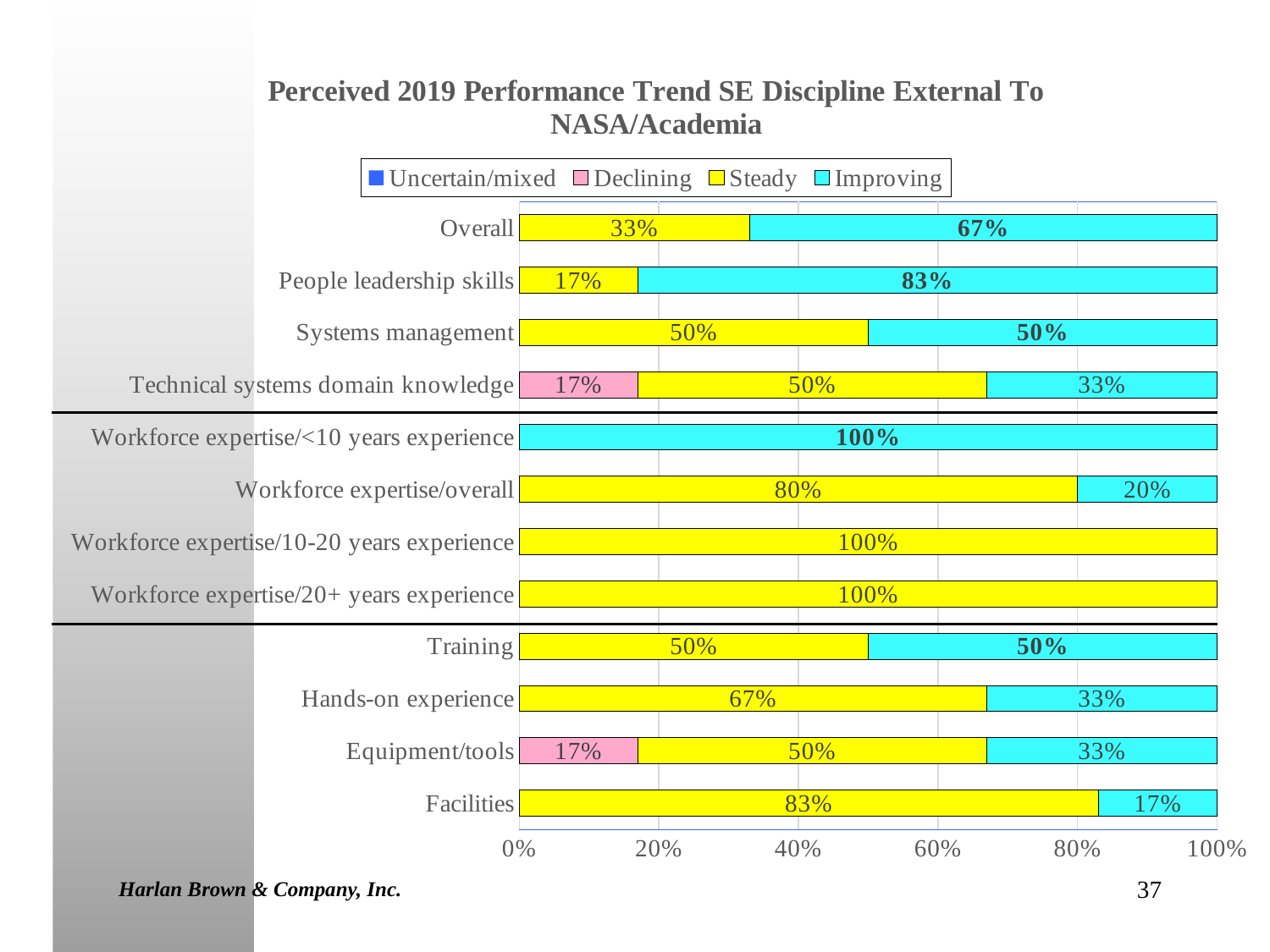
Which is larger: the Steady value for Facilities or the Steady value for Hands-on experience? Facilities What is the Improving value for Facilities? 17% What is the Steady value for Workforce expertise/overall? 80% Which category has the highest Improving value? Workforce expertise/<10 years experience What is the title of the chart? Perceived 2019 Performance Trend SE Discipline External To NASA/Academia What is the Improving value for People leadership skills? 83% What is the difference between the Improving value for Overall and the Improving value for Hands-on experience? 34% What is the Declining value for Equipment/tools? 17% What kind of chart is shown on the slide? Stacked bar chart What is the total of the Technical systems domain knowledge bar? 100% How many series does the legend list? 4 How many categories are plotted on the chart? 12